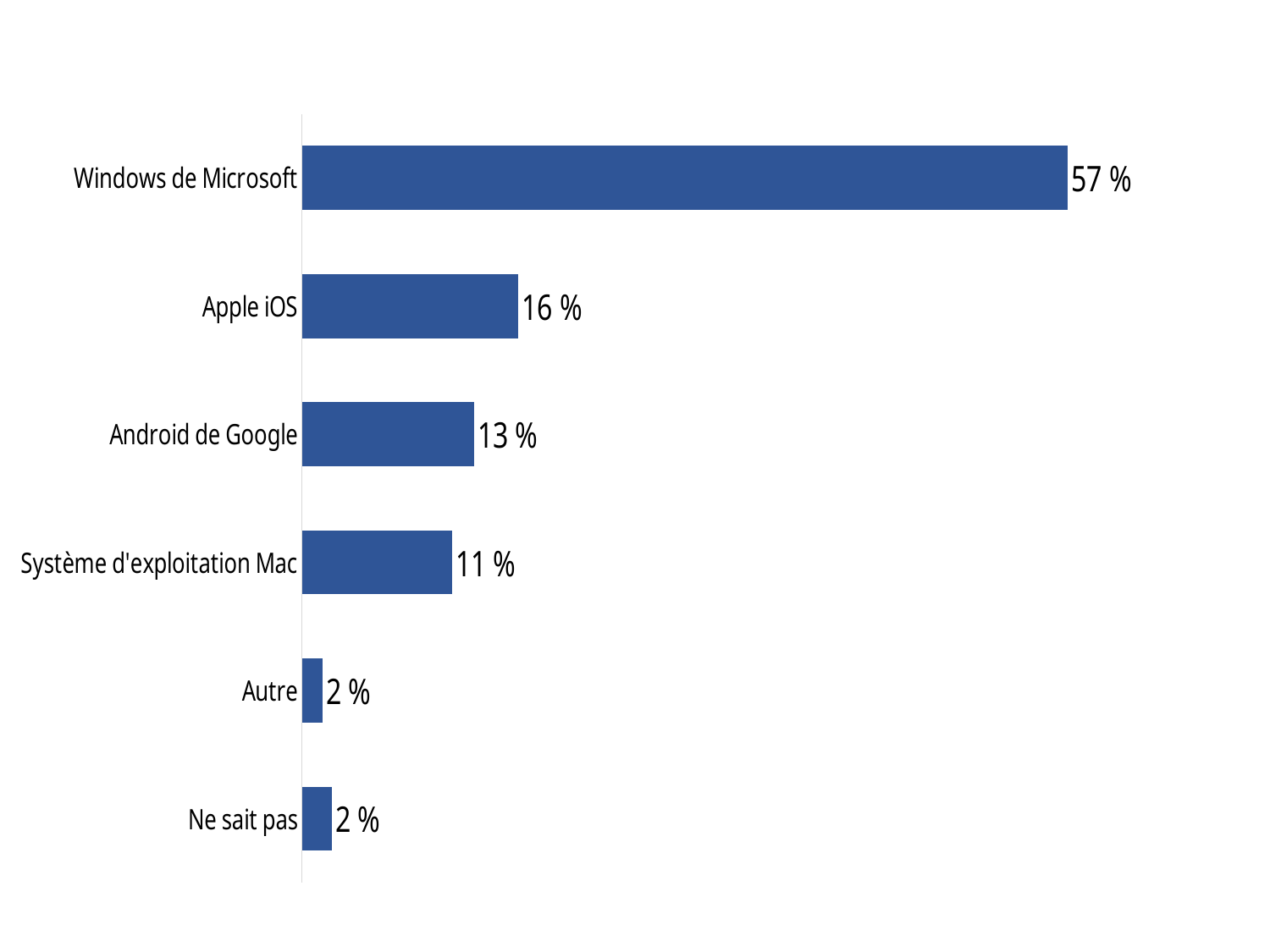
What is the value for Ne sait pas? 2 % Which category has the highest value? Windows de Microsoft What is the value for Android de Google? 13 % What is the value for Apple iOS? 16 % How many categories are shown in the chart? 6 What is the value for Système d'exploitation Mac? 11 % Which is larger, the value for Apple iOS or the value for Android de Google? Apple iOS What is the difference between the values for Android de Google and Système d'exploitation Mac? 2 % What is the difference between the values for Windows de Microsoft and Apple iOS? 41 % What colour are the bars in the chart? Blue What kind of chart is this? Bar chart What is the value for Windows de Microsoft? 57 %